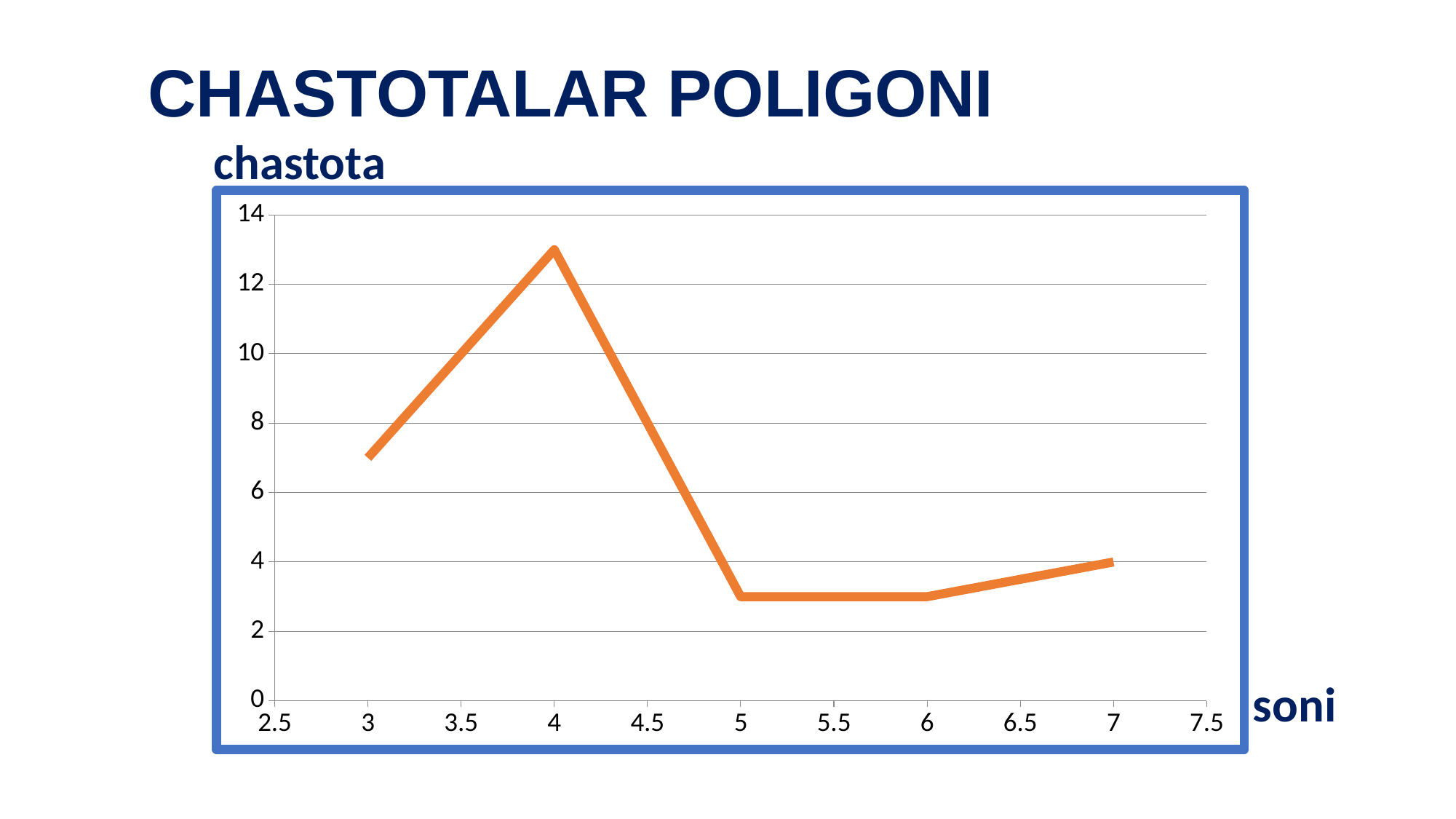
What is the chastota value at soni = 7? 4 What kind of chart is shown on the slide? line chart What is the title of the chart on the slide? CHASTOTALAR POLIGONI Does the chastota value rise or fall between soni = 4 and soni = 5? fall Does the chastota value rise or fall between soni = 3 and soni = 4? rise Is the chastota value at soni = 5 greater or less than 4? less Is the chastota value at soni = 4 greater or less than 12? greater What label is written next to the horizontal axis of the chart? soni At which value of soni does the line reach its highest chastota? 4 Which has a higher chastota value: soni = 3 or soni = 7? soni = 3 How many data points are plotted on the line? 5 Is the chastota value at soni = 3 greater or less than 6? greater